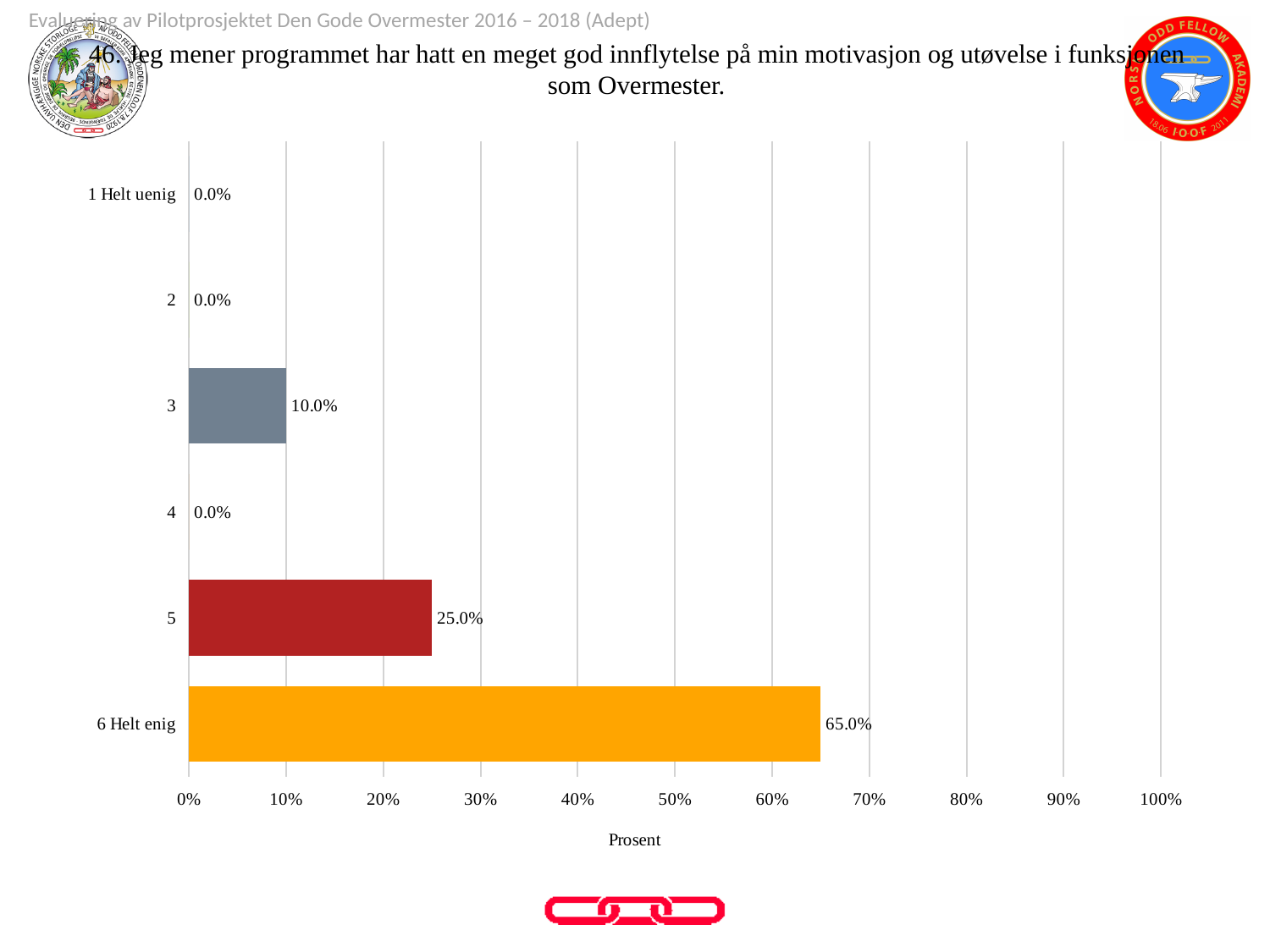
What is the difference between the values for "6 Helt enig" and category 5? 40.0% How many categories are shown on the chart? 6 Which category has the highest value? 6 Helt enig What is the value for category 5? 25.0% What is the difference between the values for category 5 and category 3? 15.0% What is the value for category 3? 10.0% What is the label of the horizontal axis? Prosent What is the value for the category "1 Helt uenig"? 0.0% What kind of chart is shown on the slide? Bar chart Which is larger, the value for category 3 or the value for category 5? 5 What is the value for the category "6 Helt enig"? 65.0% Is the value for "6 Helt enig" greater or less than 60%? greater